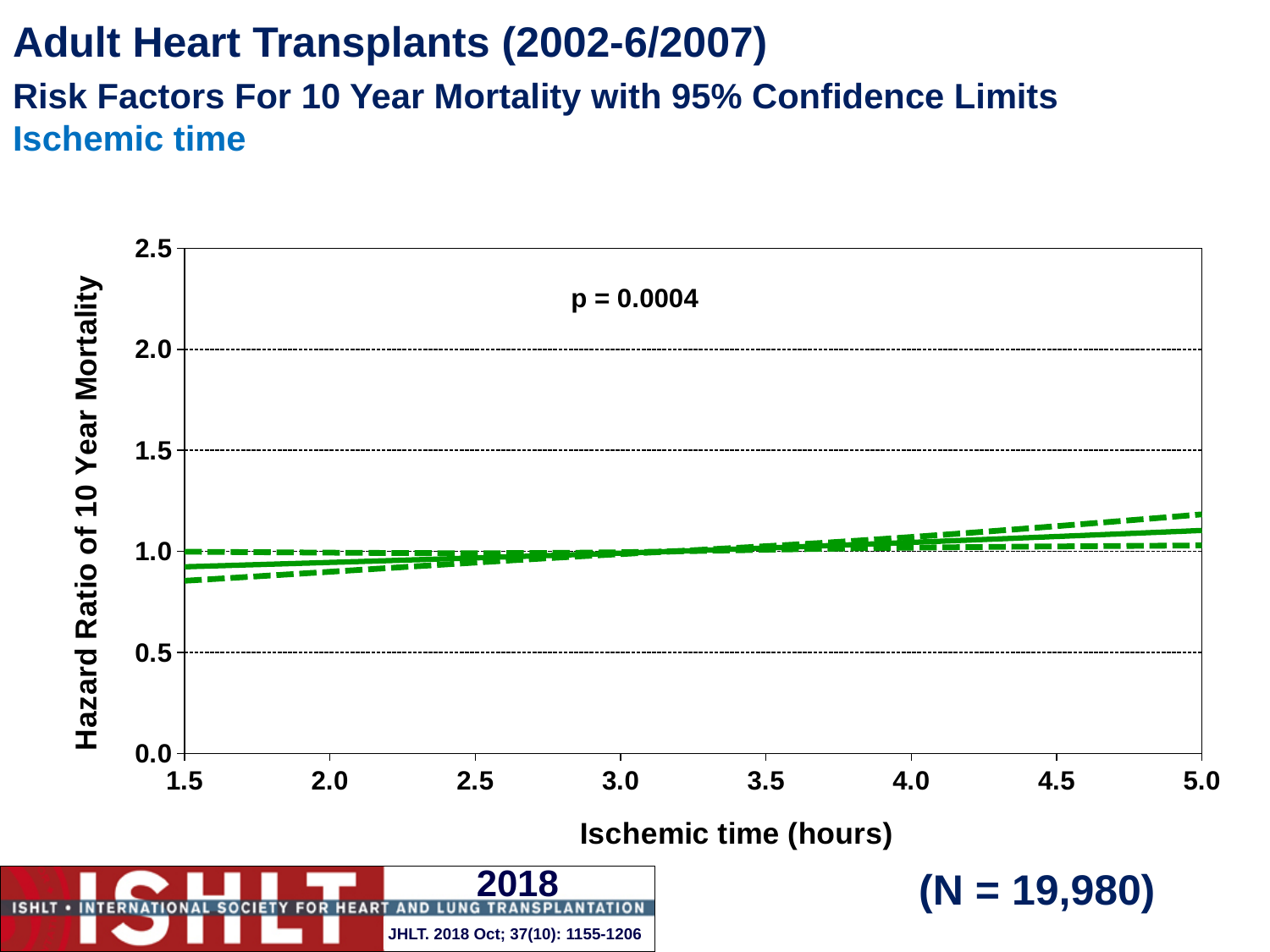
Is the hazard ratio at an ischemic time of 5.0 hours greater or less than 1.5? less How many lines are plotted on the chart (the estimate plus its confidence limits)? 3 Does the hazard ratio of 10 year mortality rise or fall as ischemic time increases from 1.5 to 5.0 hours? rise Is the hazard ratio at an ischemic time of 1.5 hours greater or less than 1.0? less What is the highest value labelled on the y axis? 2.5 How many tick marks are labelled on the x axis? 8 What sample size (N) is shown on the slide? N = 19,980 Is the upper 95% confidence limit at an ischemic time of 5.0 hours greater or less than 1.0? greater What kind of chart is shown on the slide? line chart What p-value is printed on the chart? p = 0.0004